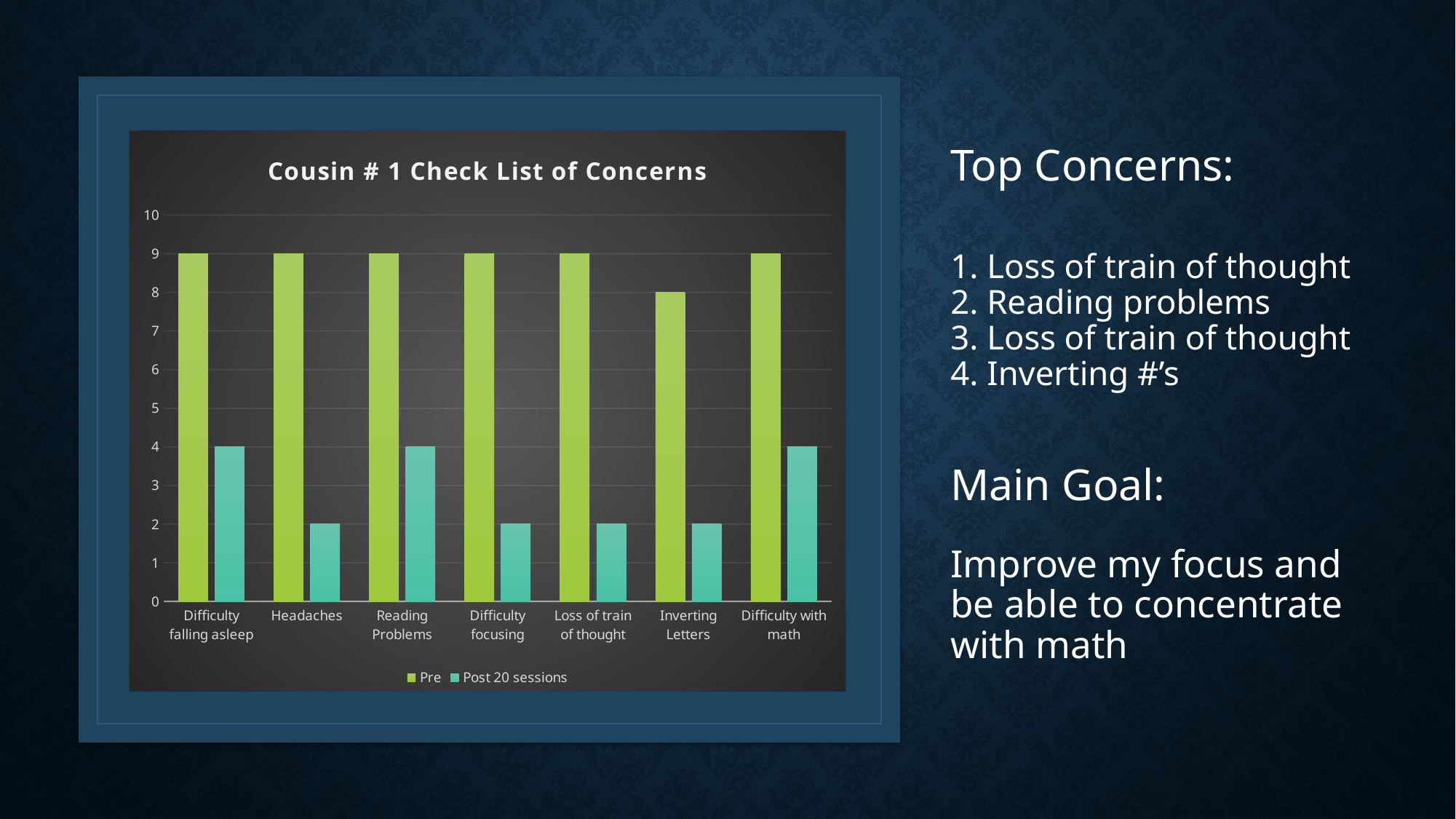
Which is larger for Loss of train of thought, the Pre value or the Post 20 sessions value? Pre Is the Post 20 sessions value for Difficulty falling asleep greater or less than 5? less How many series does the chart legend list? 2 What is the title of the chart? Cousin # 1 Check List of Concerns How many concern categories are shown on the x axis of the chart? 7 What is the Post 20 sessions value for Headaches? 2 What are the two series named in the chart legend? Pre and Post 20 sessions What is the Pre value for Inverting Letters? 8 What is the difference between the Pre and Post 20 sessions values for Difficulty with math? 5 Which category has the lowest Pre value? Inverting Letters What kind of chart is shown on the slide? bar chart What is the Post 20 sessions value for Reading Problems? 4